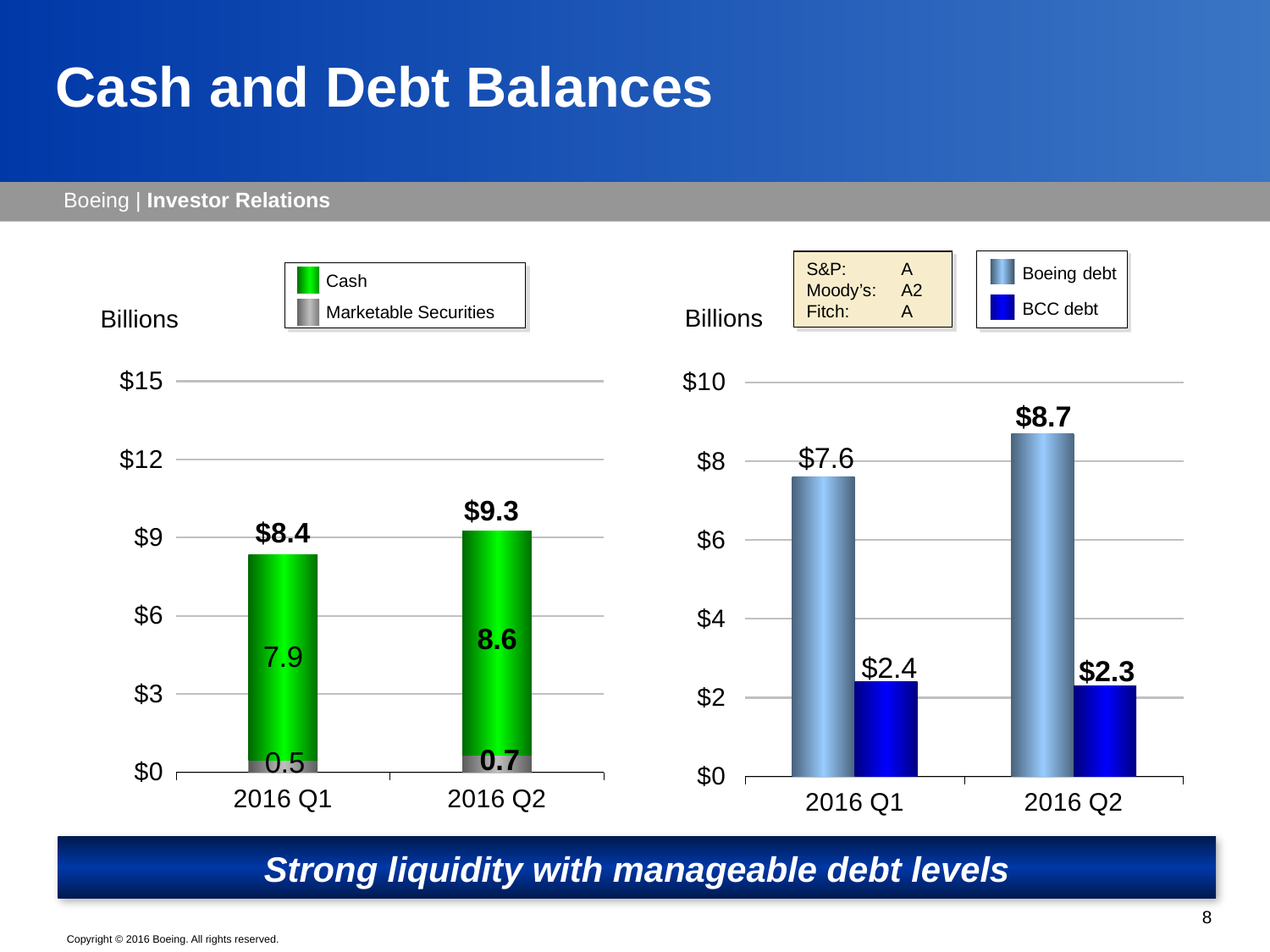
In the right chart, which quarter has the higher Boeing debt? 2016 Q2 In the left chart, does the total cash and marketable securities balance rise or fall from 2016 Q1 to 2016 Q2? rise In the left chart, what is the total of the stacked bar for 2016 Q1? $8.4 In the left chart, what is the difference between the Cash values for 2016 Q2 and 2016 Q1? 0.7 In the left chart, what is the Marketable Securities value for 2016 Q1? 0.5 In the right chart, what is the Boeing debt value for 2016 Q2? $8.7 What kind of chart is the right chart? bar chart In the right chart, what is the BCC debt value for 2016 Q1? $2.4 In the left chart, how many series does the legend list? 2 In the left chart, what is the Cash value for 2016 Q2? 8.6 In the right chart, what colour represents BCC debt in the legend? dark blue In the right chart, what is the difference between Boeing debt and BCC debt in 2016 Q1? $5.2